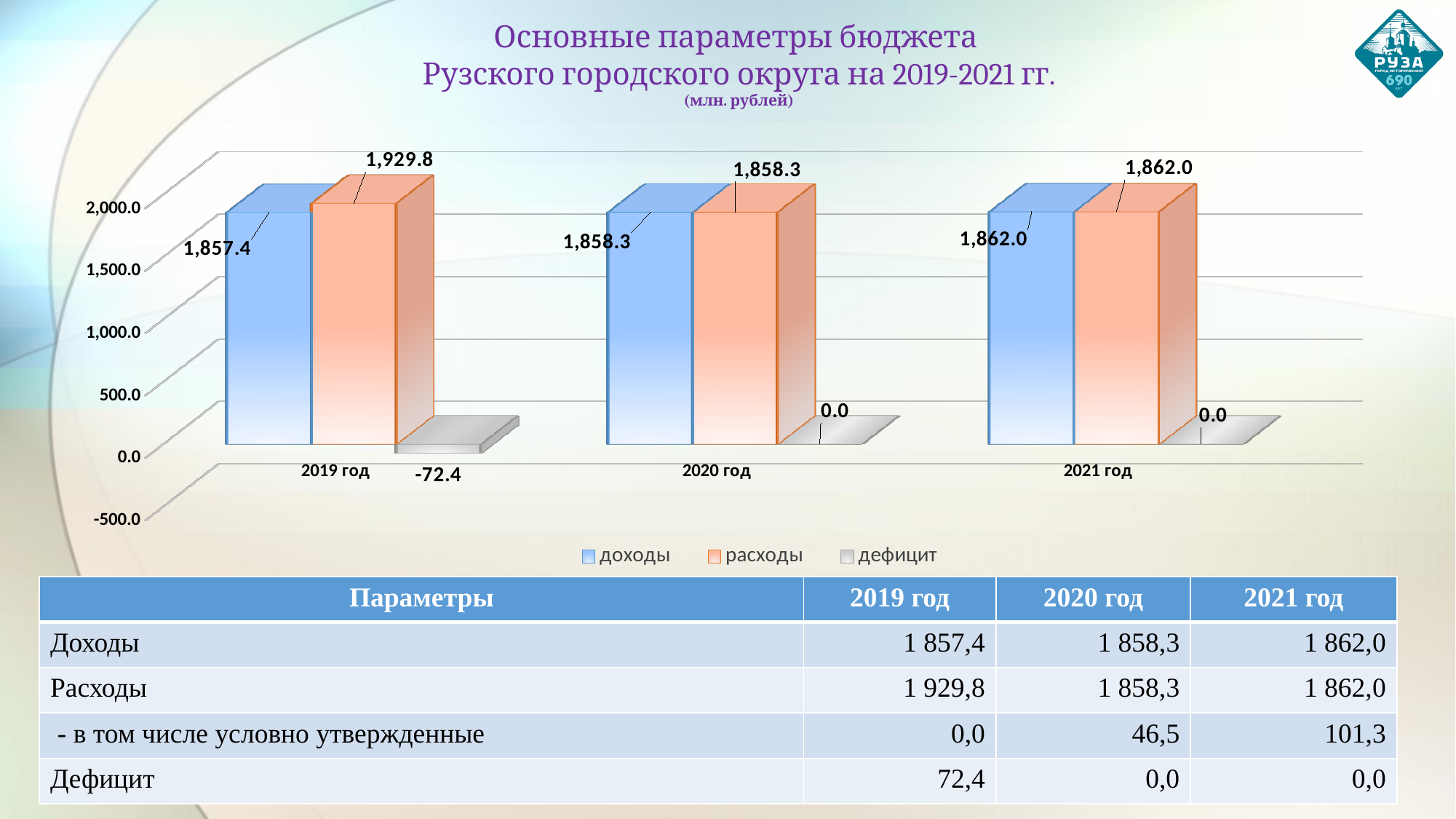
What is the value of расходы for 2021 год? 1,862.0 What is the value of доходы for 2019 год? 1,857.4 Do the доходы values rise or fall from 2019 год to 2021 год? rise What is the value of дефицит for 2020 год? 0.0 In which year is расходы highest? 2019 год What is the value of дефицит for 2019 год? -72.4 What is the value of расходы for 2019 год? 1,929.8 In which year is доходы lowest? 2019 год Which is larger in 2019 год, доходы or расходы? расходы How many series does the legend list? 3 What is the difference between расходы and доходы in 2019 год? 72.4 What kind of chart is shown on the slide? bar chart